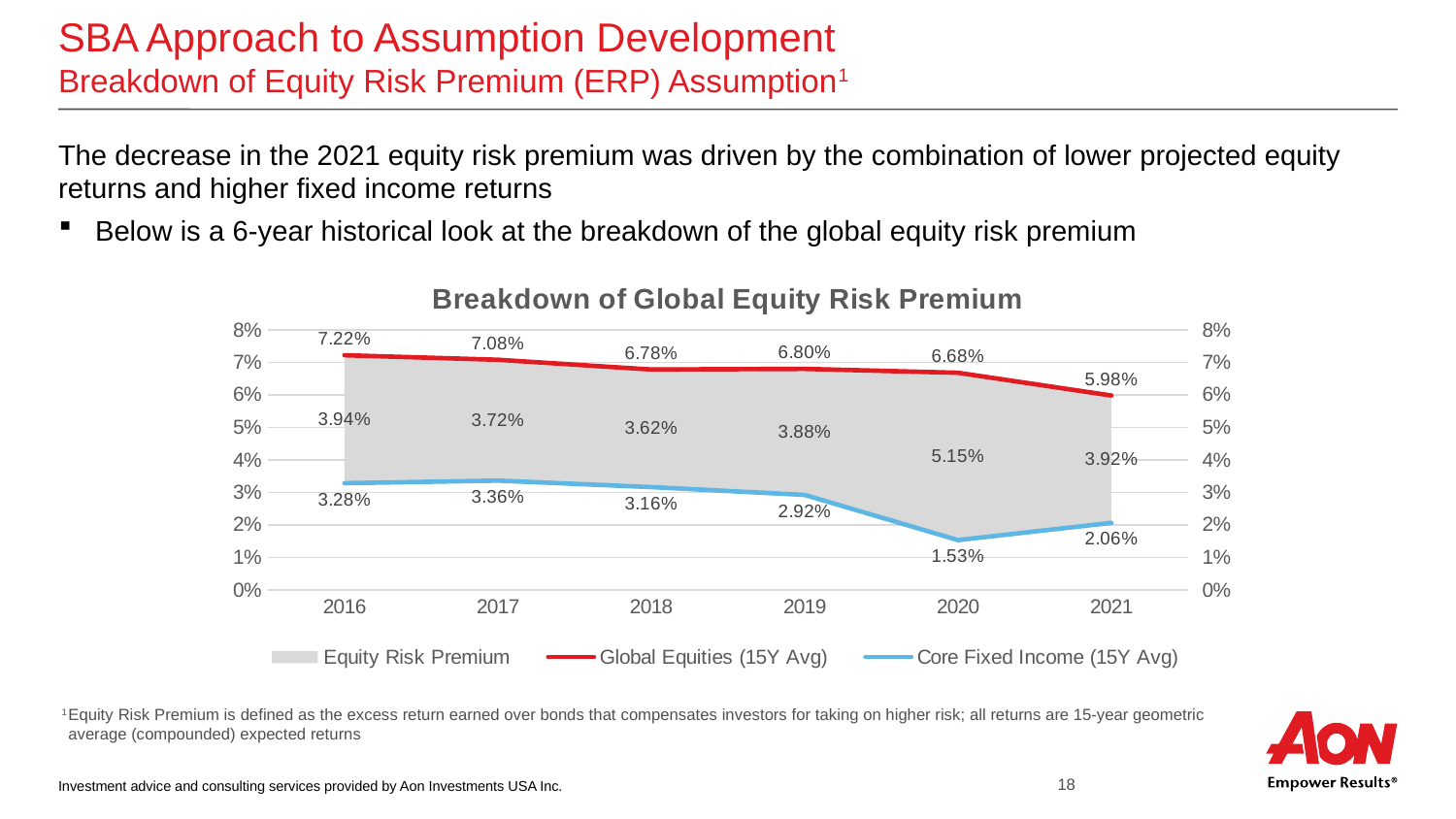
What is the difference between the Global Equities (15Y Avg) value in 2016 and in 2021? 1.24% How many years are shown on the x axis? 6 In which year is the Global Equities (15Y Avg) value highest? 2016 Does the Global Equities (15Y Avg) line generally rise or fall from 2016 to 2021? fall How many series does the legend list? 3 What is the Equity Risk Premium value for 2019? 3.88% What is the Global Equities (15Y Avg) value for 2021? 5.98% In which year is the Equity Risk Premium highest? 2020 In which year is the Core Fixed Income (15Y Avg) value lowest? 2020 What colour is the Core Fixed Income (15Y Avg) line? Blue Which is larger, the Equity Risk Premium in 2017 or in 2018? 2017 What is the Core Fixed Income (15Y Avg) value for 2020? 1.53%